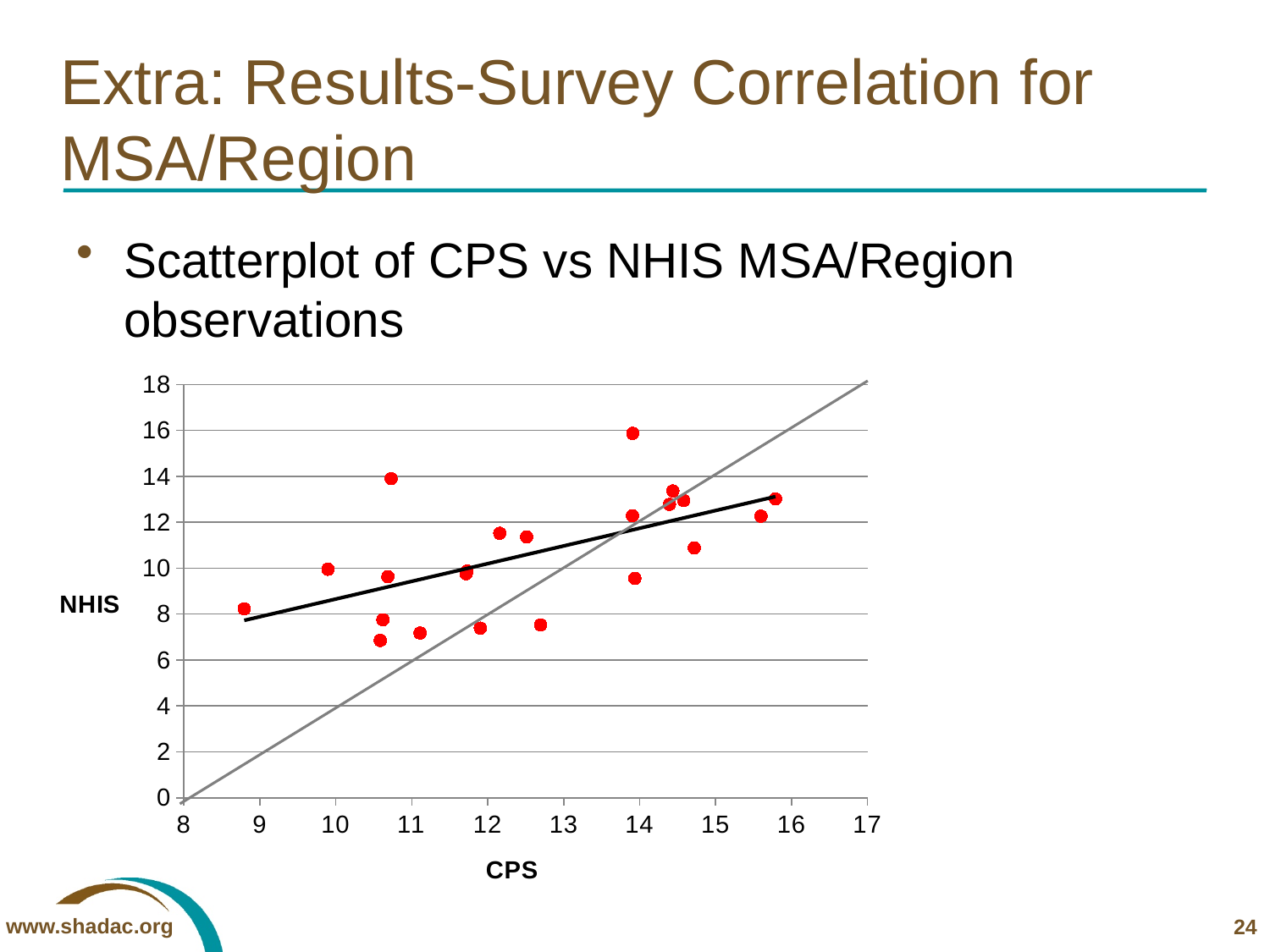
What is the minimum value shown on the CPS axis? 8 What is the label of the horizontal axis of the chart? CPS Is the highest NHIS value among the plotted points greater or less than 14? greater What is the maximum value shown on the NHIS axis? 18 Is the NHIS value of the point with the lowest CPS value greater or less than 10? less Does the black fitted line in the chart rise or fall as CPS increases? Rises What is the maximum value shown on the CPS axis? 17 Is the lowest NHIS value among the plotted points greater or less than 8? less What kind of chart is shown on the slide? Scatter plot What is the label of the vertical axis of the chart? NHIS